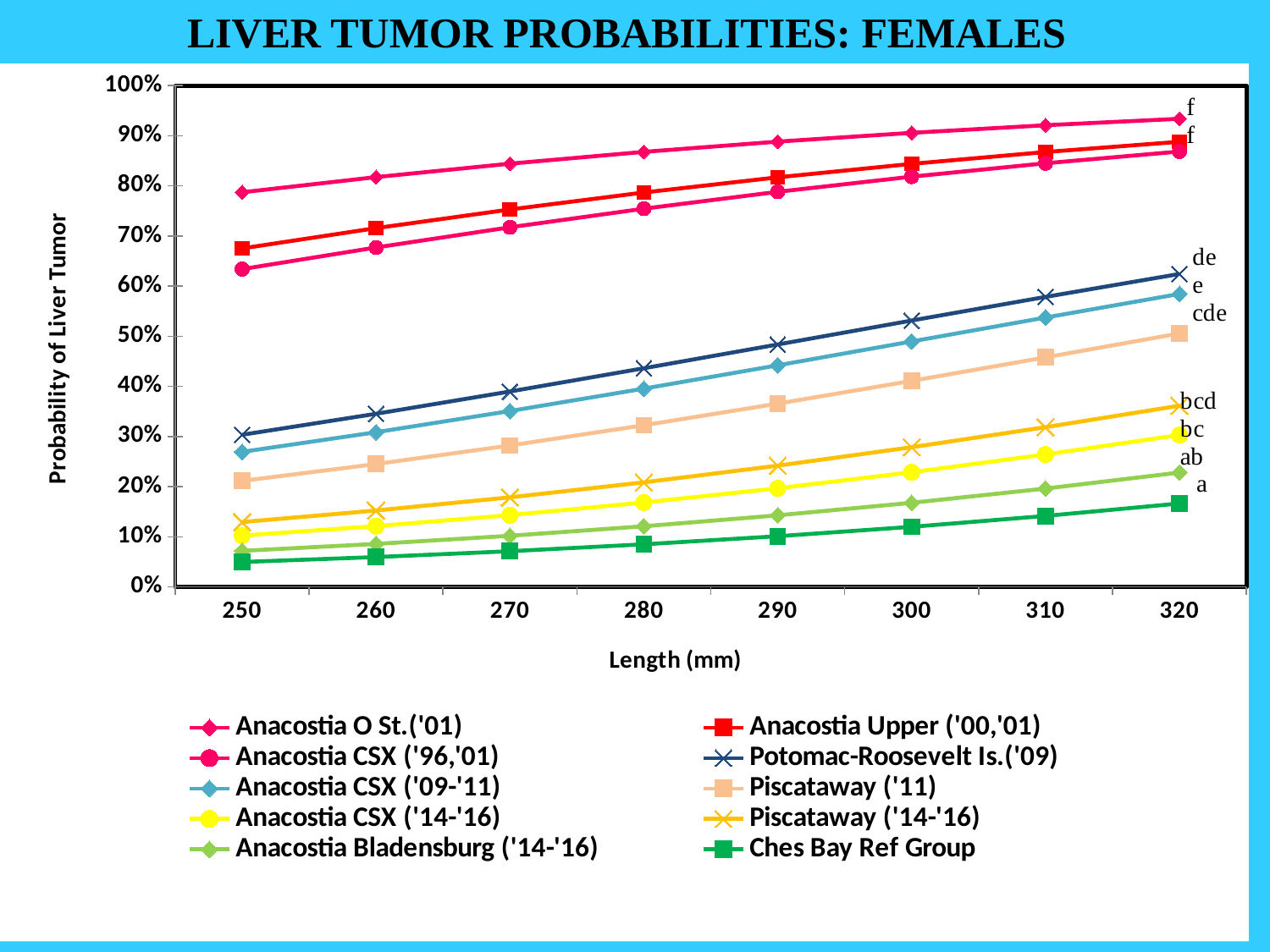
How many series does the legend list? 10 What kind of chart is shown on the slide? line chart What is the title of the chart? LIVER TUMOR PROBABILITIES: FEMALES Is the value for Potomac-Roosevelt Is.('09) at 320 mm greater or less than 50%? greater Is the value for Ches Bay Ref Group at 320 mm greater or less than 20%? less Which series has the lowest probability of liver tumor at 250 mm? Ches Bay Ref Group What is the label of the x axis? Length (mm) Which series has the highest probability of liver tumor at 320 mm? Anacostia O St.('01) Is the value for Anacostia O St.('01) at 250 mm greater or less than 70%? greater How many length values are marked along the x axis? 8 Does the probability for Anacostia O St.('01) rise or fall as length increases from 250 to 320 mm? rise At 300 mm, which is larger: the value for Piscataway ('11) or the value for Anacostia CSX ('14-'16)? Piscataway ('11)